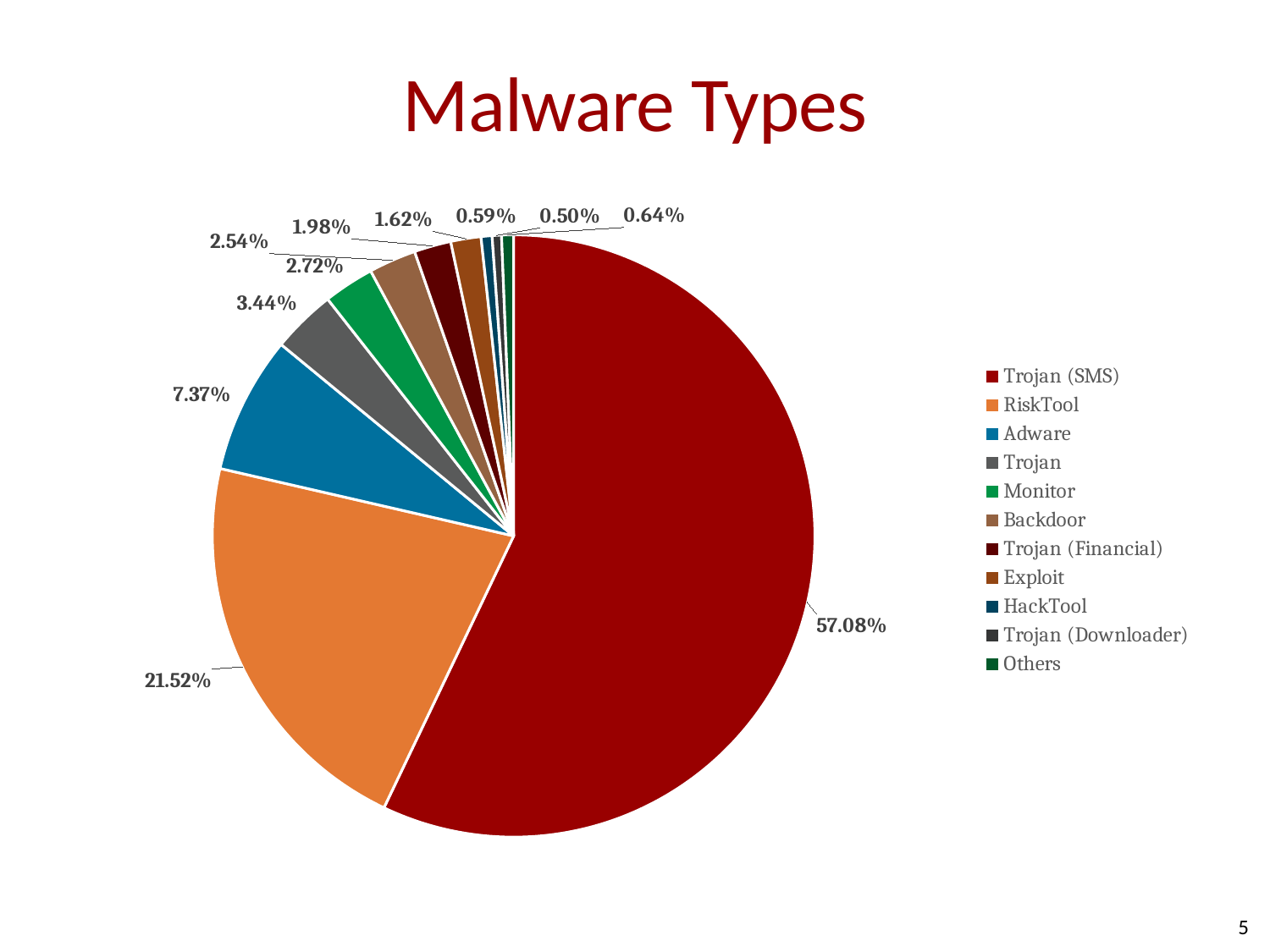
What is the value shown for Adware? 7.37% Which malware type has the largest slice of the pie? Trojan (SMS) What is the title of the chart? Malware Types What is the value shown for Monitor? 2.72% What kind of chart is shown on the slide? pie chart What is the difference between the Trojan (SMS) share and the RiskTool share? 35.56% How many categories does the legend list? 11 What is the value shown for RiskTool? 21.52% Which malware type has the smallest slice of the pie? Trojan (Downloader) What share of the pie does Trojan (SMS) account for? 57.08% Which is larger, the share for Adware or the share for Trojan? Adware What colour is the slice for RiskTool? orange